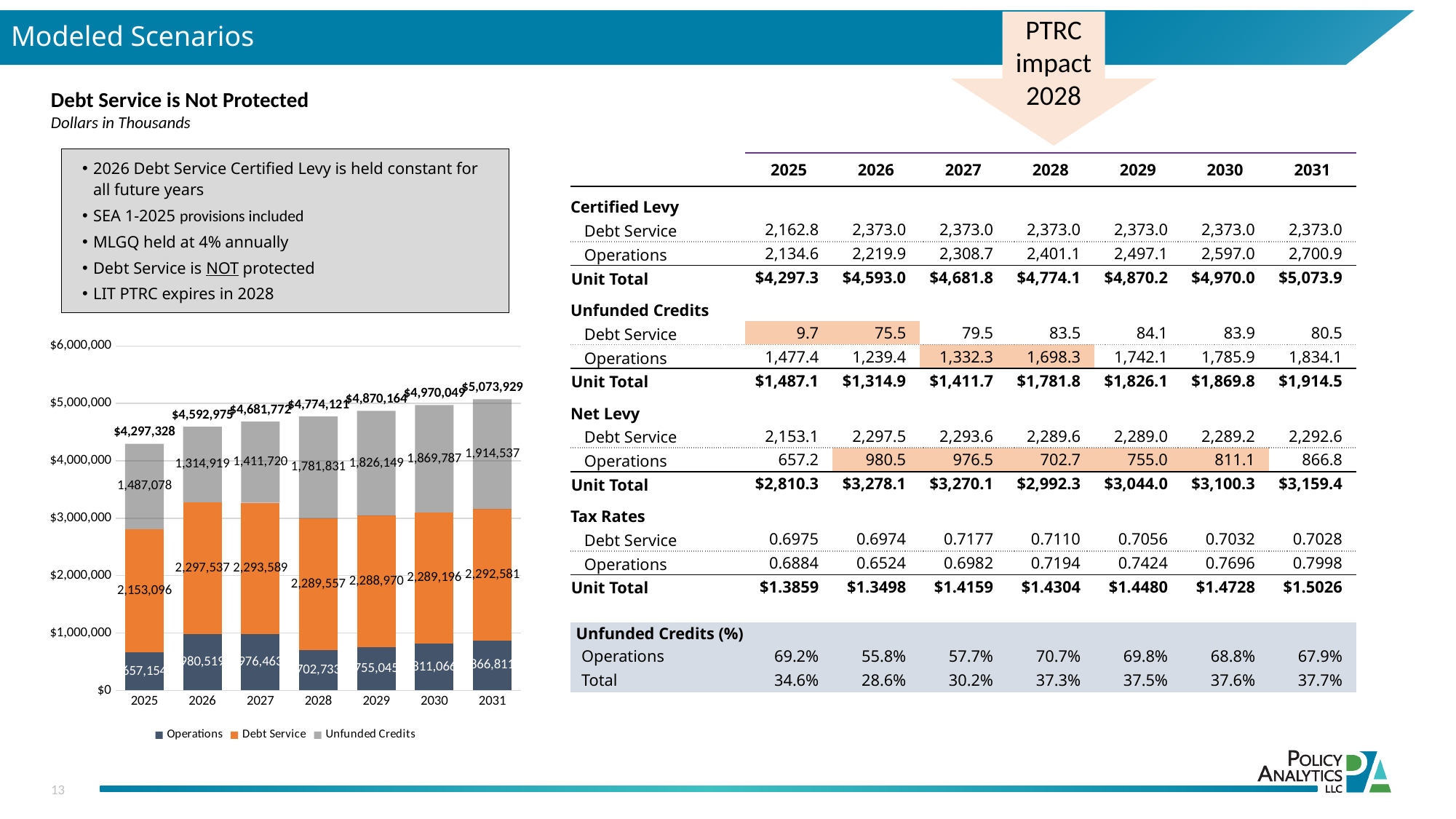
Which year has the highest total bar in the chart? 2031 Do the total bar values rise or fall from 2025 to 2031? rise What kind of chart is shown on the slide? bar chart What is the difference between the total for 2031 and the total for 2025? $776,601 Which is larger in the chart: Unfunded Credits for 2026 or for 2027? 2027 What is the Debt Service value for 2025 in the chart? 2,153,096 How many years are shown on the x axis of the chart? 7 Which year has the lowest total bar in the chart? 2025 What is the total labeled above the 2031 bar? $5,073,929 How many series does the chart legend list? 3 What is the Unfunded Credits value for 2028 in the chart? 1,781,831 Which colour represents Debt Service in the chart legend? orange